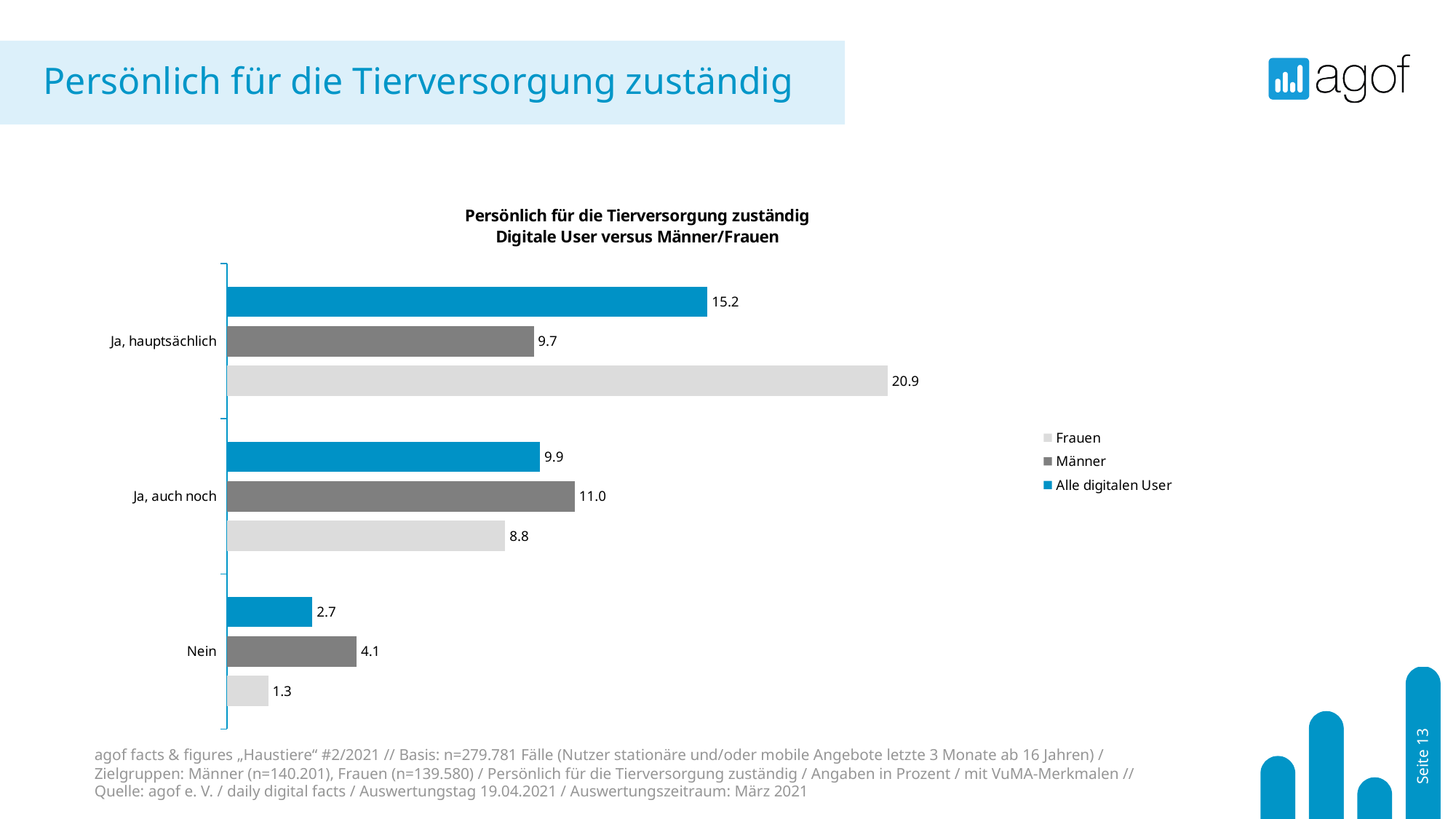
Which series has the lowest value in the 'Nein' category? Frauen What kind of chart is shown on the slide? Bar chart What is the difference between the Frauen and Männer values in the 'Ja, hauptsächlich' category? 11.2 What is the difference between the Männer and Alle digitalen User values in the 'Nein' category? 1.4 Which series has the highest value in the 'Ja, hauptsächlich' category? Frauen What is the value for Alle digitalen User in the 'Nein' category? 2.7 What is the value for Männer in the 'Ja, auch noch' category? 11.0 Which is larger in the 'Ja, auch noch' category: the value for Männer or the value for Frauen? Männer How many series does the legend list? 3 Which colour represents the series 'Alle digitalen User' in the chart? Blue How many categories are shown on the chart? 3 What is the value for Frauen in the 'Ja, hauptsächlich' category? 20.9